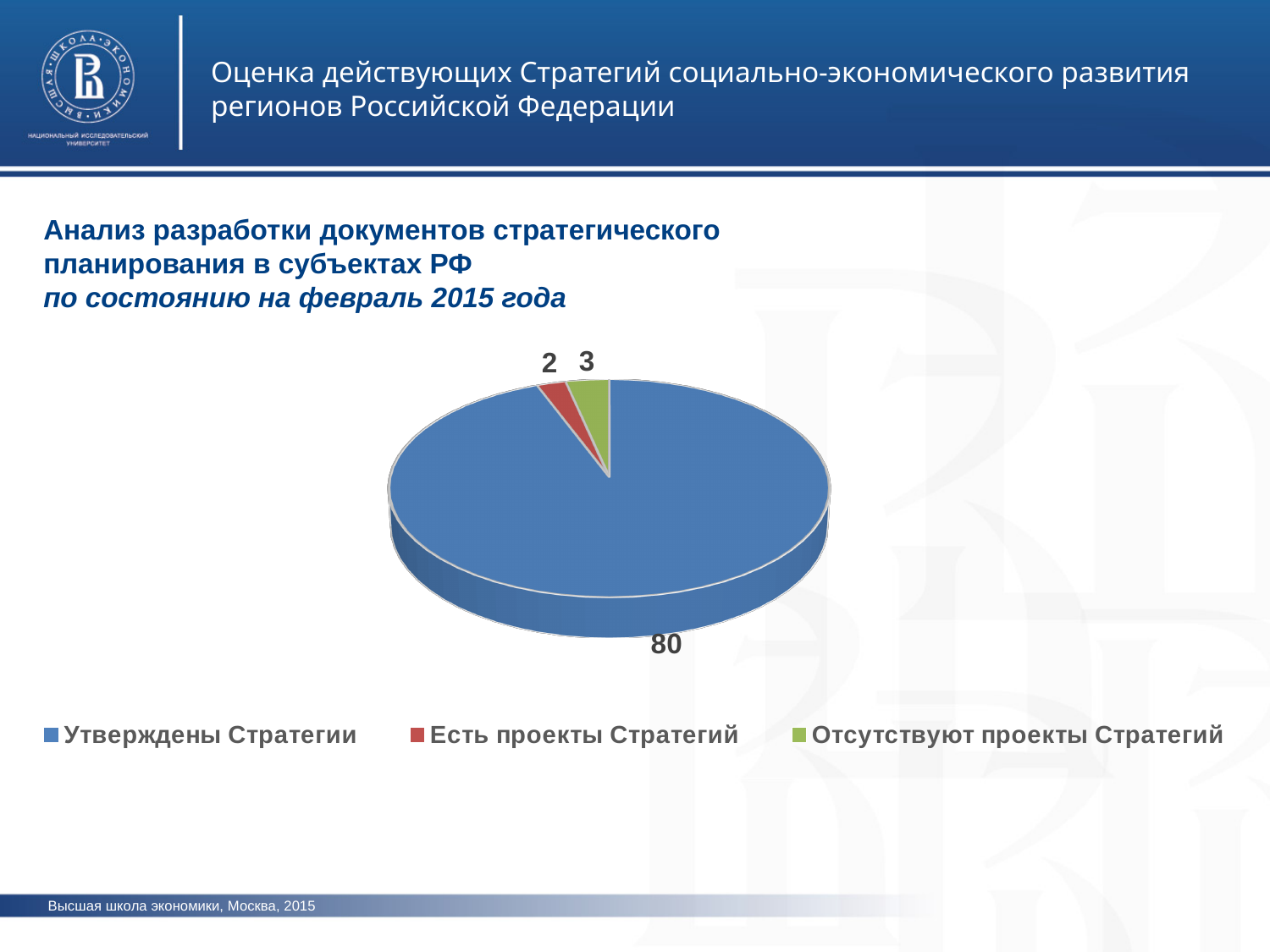
Which is larger: the value for "Есть проекты Стратегий" or for "Отсутствуют проекты Стратегий"? Отсутствуют проекты Стратегий How many slices does the pie chart have? 3 Which category has the smallest slice of the pie? Есть проекты Стратегий What is the difference between the values for "Утверждены Стратегии" and "Отсутствуют проекты Стратегий"? 77 What kind of chart is shown on the slide? Pie chart What value is shown for the slice "Отсутствуют проекты Стратегий"? 3 What value is shown for the slice "Есть проекты Стратегий"? 2 What value is shown for the slice "Утверждены Стратегии"? 80 What is the total of all the values shown on the pie chart? 85 What is the difference between the values for "Отсутствуют проекты Стратегий" and "Есть проекты Стратегий"? 1 What colour is the slice for "Утверждены Стратегии"? Blue Which category has the largest slice of the pie? Утверждены Стратегии